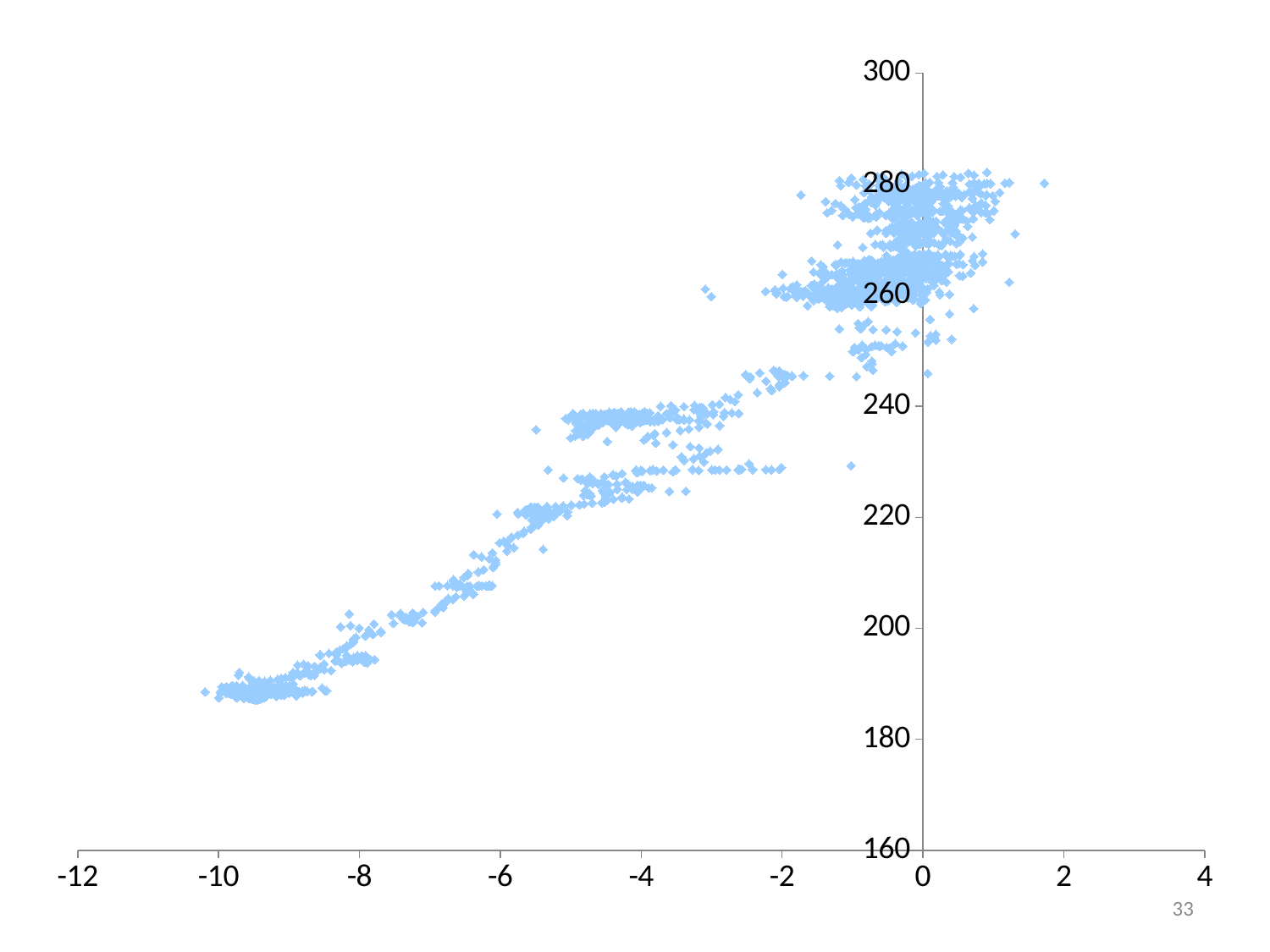
Are the points plotted near x = -4 greater or less than 260 on the vertical axis? less Are the points plotted near x = 0 greater or less than 240 on the vertical axis? greater Do the plotted values generally rise or fall as you move from left to right along the x axis? rise What is the lowest value labelled on the vertical axis? 160 Are the points plotted near x = -8 greater or less than 220 on the vertical axis? less What kind of chart is shown on the slide? scatter chart What is the leftmost value labelled on the horizontal axis? -12